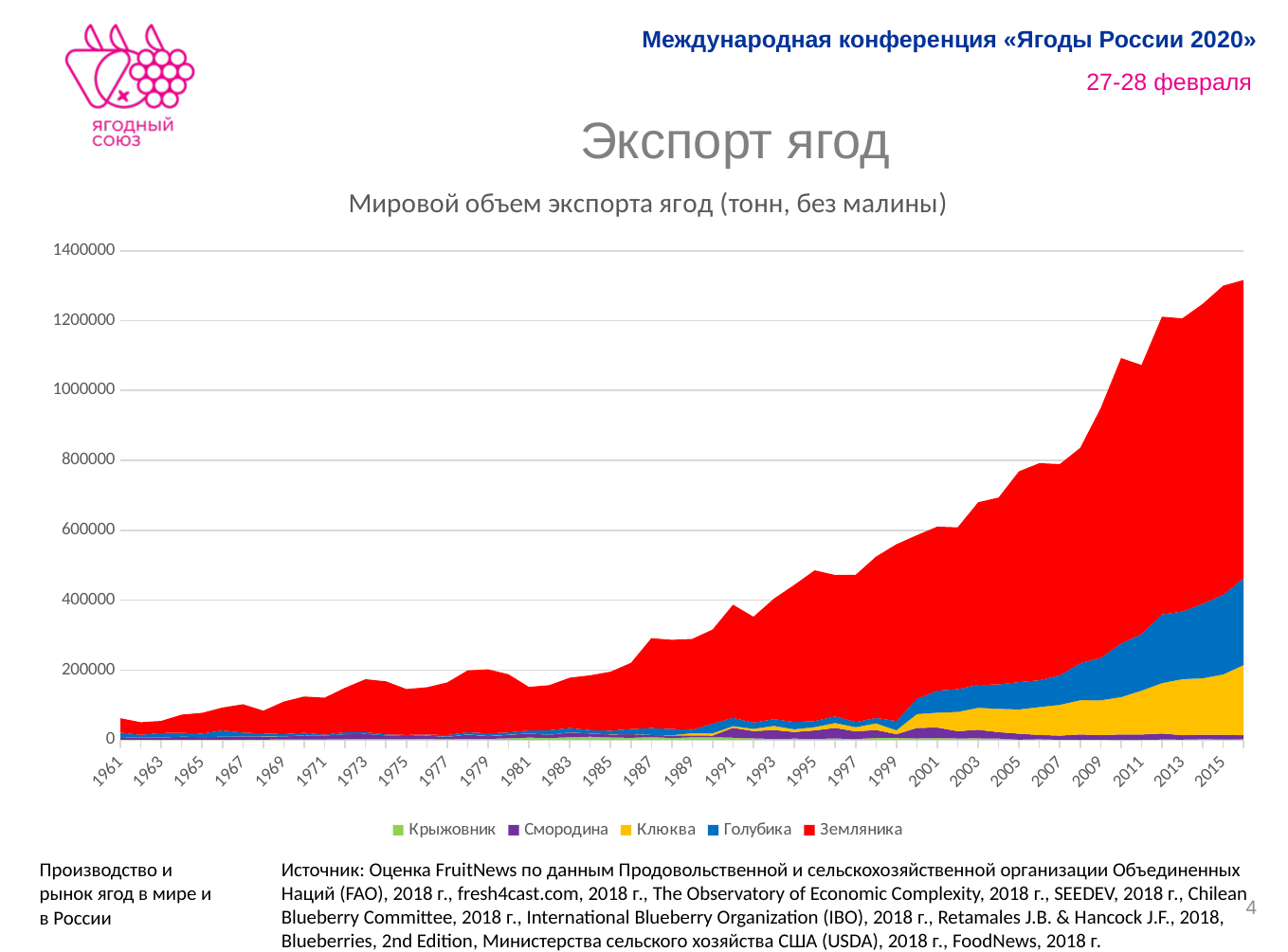
Is the total export volume in 2009 greater or less than 800000? greater Which series is shown in red? Земляника What is the highest value shown on the vertical axis? 1400000 Is the total export volume in 2015 greater or less than 1200000? greater Is the total export volume in 2001 greater or less than 800000? less How many series does the legend list? 5 Which series accounts for the largest share of the total export volume in 2015? Земляника Which is larger in 2015: the export volume of Голубика or of Смородина? Голубика What kind of chart is shown on the slide? Stacked area chart Does the total world berry export volume rise or fall from 1961 to 2016? Rise What is the title of the chart? Мировой объем экспорта ягод (тонн, без малины)